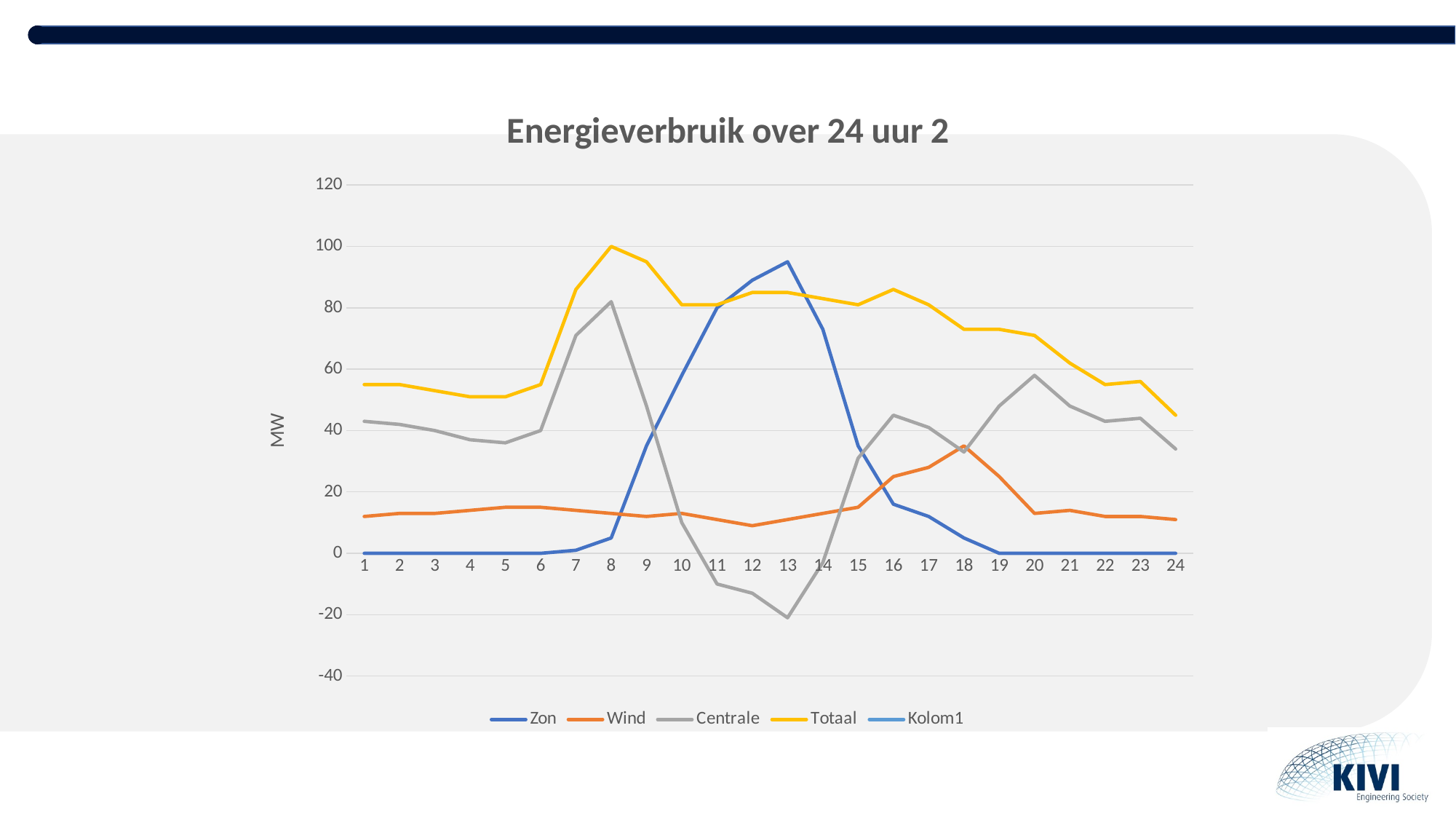
Is the value for Zon at hour 13 greater or less than 80? greater Does the Totaal line rise or fall from hour 16 to hour 24? fall What is the label on the vertical axis? MW What kind of chart is shown on the slide? line chart At hour 8, which series has the larger value, Centrale or Zon? Centrale Is the value for Centrale at hour 13 greater or less than 0? less How many hours (points) are plotted along the x axis? 24 At which hour does Centrale reach its lowest value? 13 Is the value for Wind at hour 18 greater or less than 40? less At which hour does Totaal reach its highest value? 8 What is the value of Zon at hour 3? 0 How many series does the legend list? 5